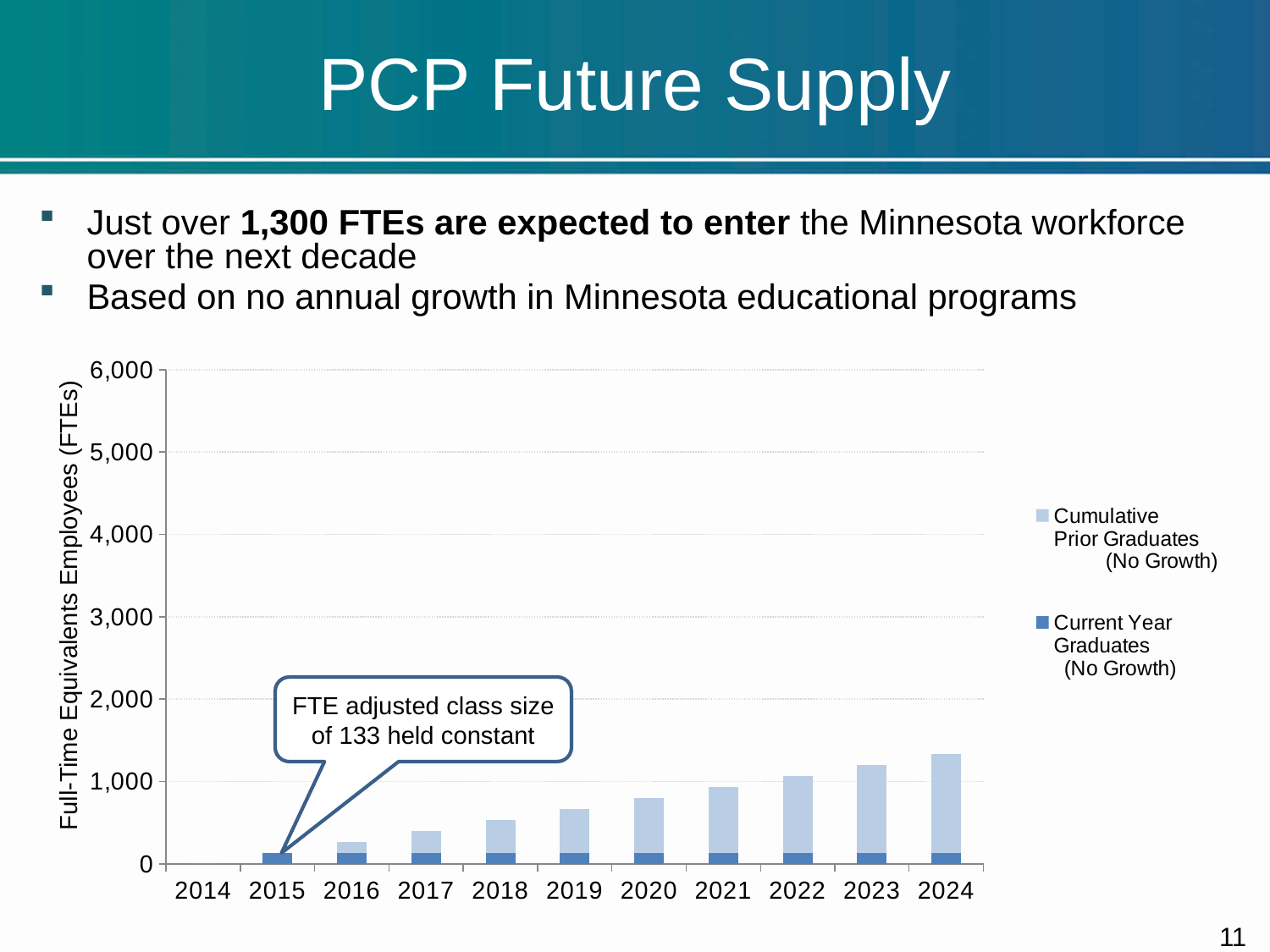
Is the total bar height for 2024 greater or less than 1,000? greater How many series does the chart legend list? 2 Do the bar totals rise or fall from 2015 to 2024? rise How many years are labeled on the x axis of the chart? 11 Which year has a taller bar, 2020 or 2023? 2023 Is the total bar height for 2024 greater or less than 2,000? less What is the label on the y axis of the chart? Full-Time Equivalents Employees (FTEs) What does the callout box on the chart say? FTE adjusted class size of 133 held constant Among the years with a visible bar, which year has the shortest bar? 2015 Which year has the tallest bar in the chart? 2024 What kind of chart is shown on the slide? bar chart Is the total bar height for 2019 greater or less than 1,000? less